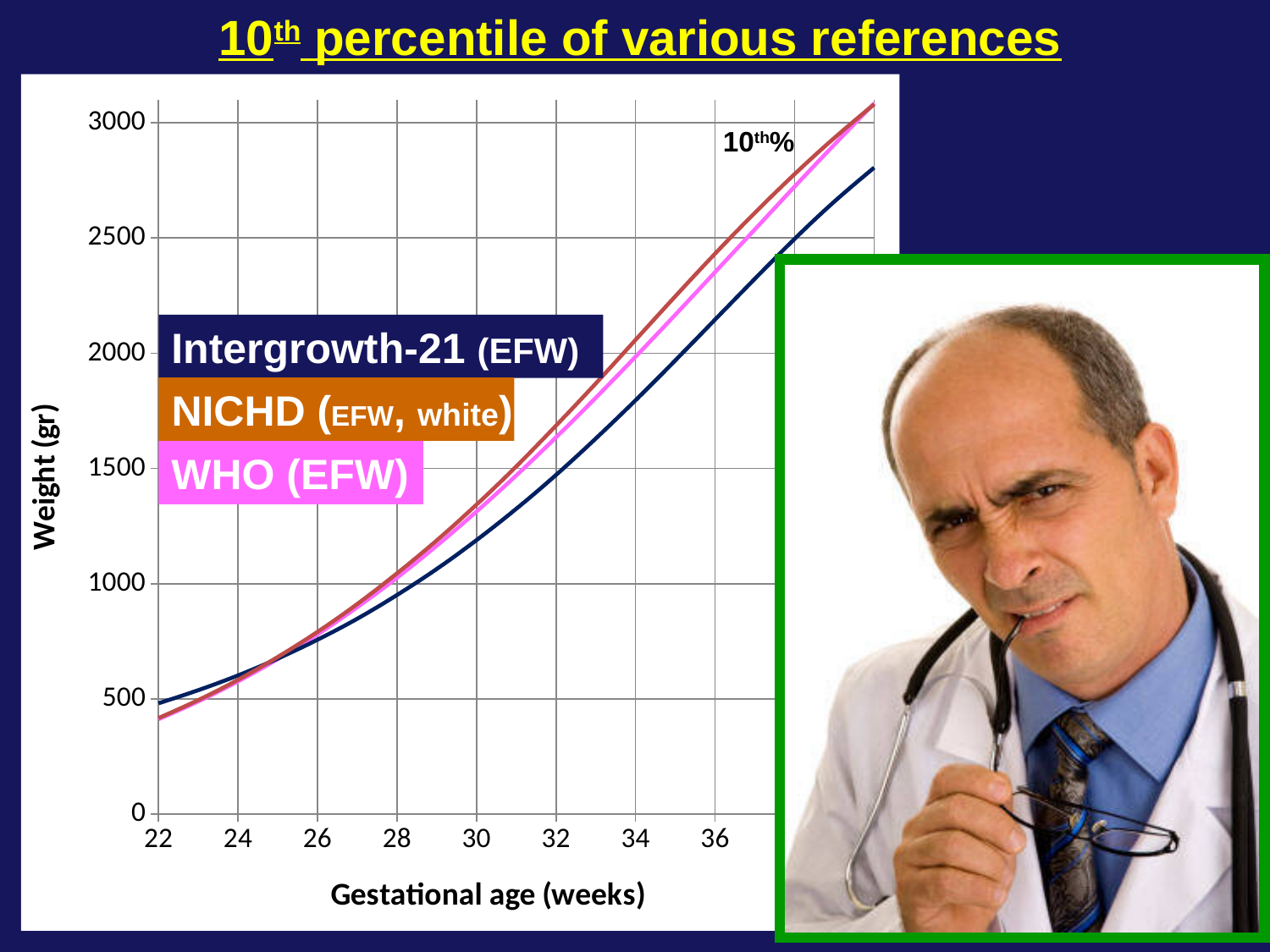
What is the label of the y axis? Weight (gr) At 22 weeks, which is higher: Intergrowth-21 (EFW) or NICHD (EFW, white)? Intergrowth-21 (EFW) What kind of chart is shown on the slide? line chart What is the title of the slide? 10th percentile of various references What is the lowest gestational age labelled on the x axis? 22 Is the Intergrowth-21 (EFW) value at 28 weeks greater or less than 1000? less At 36 weeks, which is higher: NICHD (EFW, white) or Intergrowth-21 (EFW)? NICHD (EFW, white) Do the weight values rise or fall as gestational age increases? rise Is the Intergrowth-21 (EFW) value at 30 weeks greater or less than 1000? greater How many series does the legend list? 3 Is the NICHD (EFW, white) value at 36 weeks greater or less than 2500? less